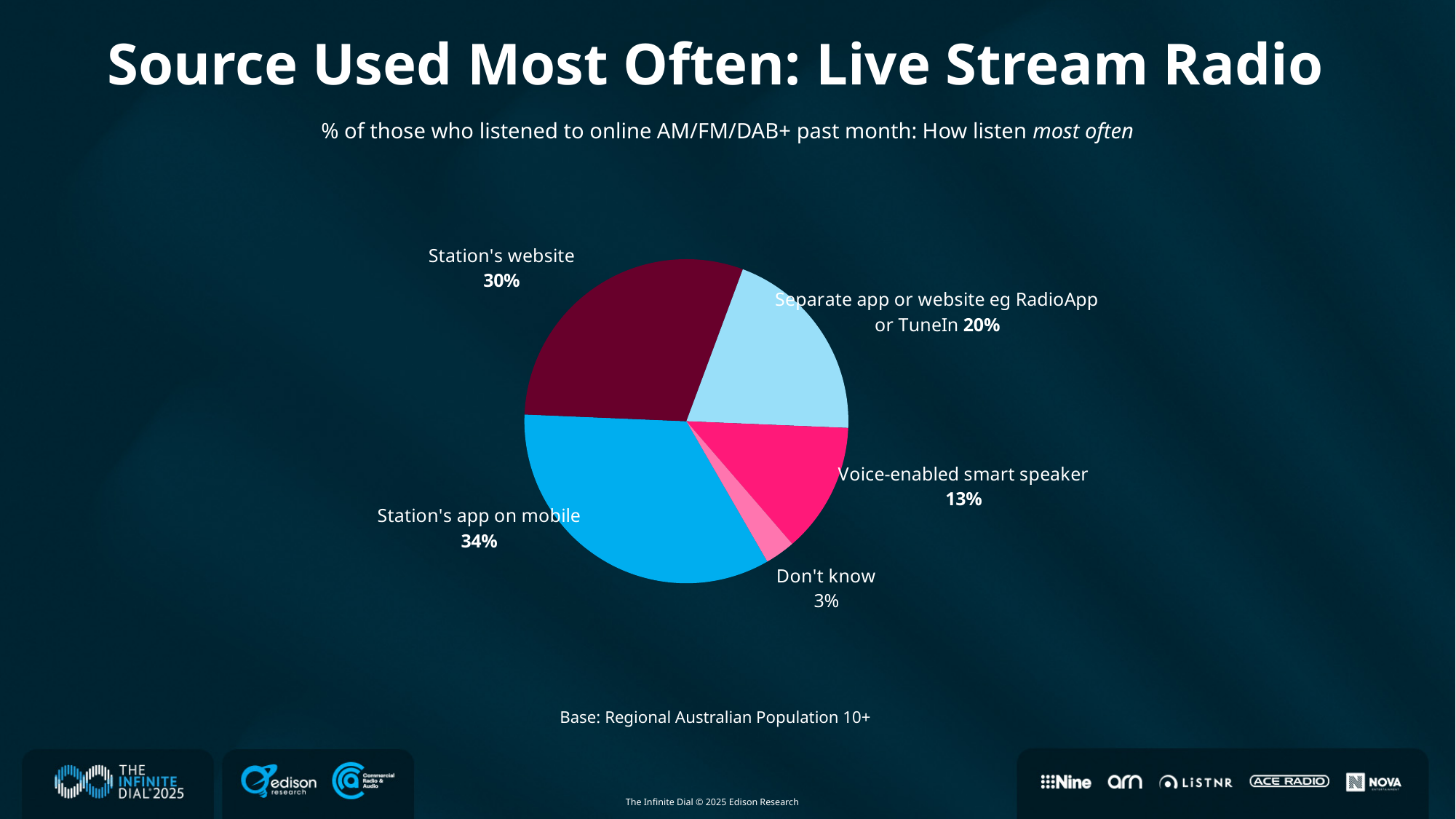
Which is larger: the share for a separate app or website, or the share for a voice-enabled smart speaker? Separate app or website Which source has the largest share of the pie? Station's app on mobile What percentage listen most often via the station's website? 30% How many slices does the pie chart have? 5 Which slice of the pie is the smallest? Don't know What is the difference in percentage points between the station's app on mobile and the station's website? 4 What percentage listen most often via a separate app or website eg RadioApp or TuneIn? 20% What is the title of the slide? Source Used Most Often: Live Stream Radio What percentage listen most often via a voice-enabled smart speaker? 13% What kind of chart is shown on the slide? Pie chart What percentage answered 'Don't know'? 3% What percentage listen most often via the station's app on mobile? 34%